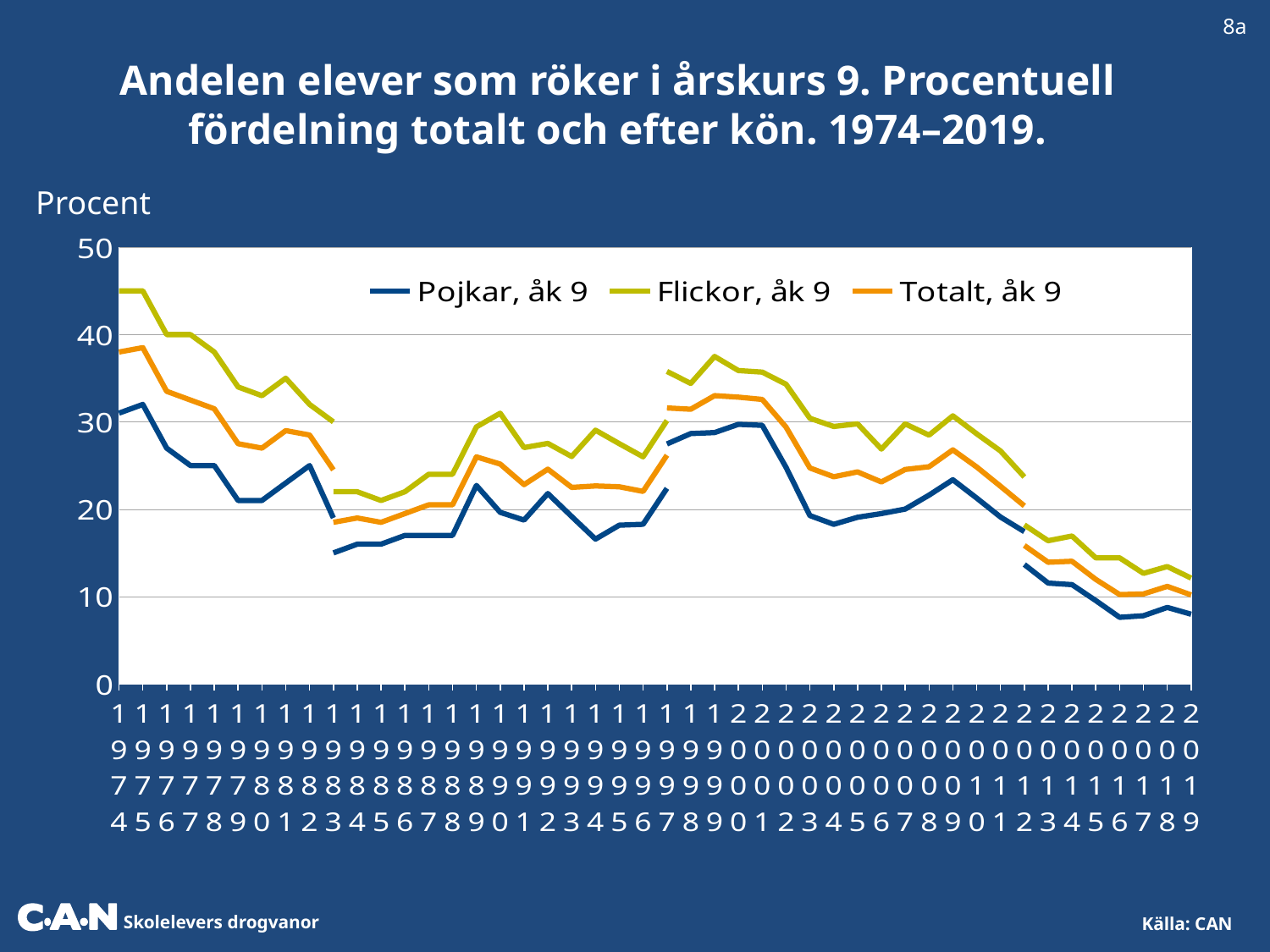
What kind of chart is shown on the slide? line chart Is the value for Pojkar, åk 9 in 1994 greater or less than 20? less Is the value for Pojkar, åk 9 in 2019 greater or less than 10? less Overall, do the values for Flickor, åk 9 rise or fall from 1974 to 2019? fall What are the three series named in the legend? Pojkar, åk 9; Flickor, åk 9; Totalt, åk 9 What is the label shown above the vertical axis? Procent Which series has the highest value in 1974? Flickor, åk 9 Is the value for Flickor, åk 9 in 1974 greater or less than 40? greater How many series does the legend list? 3 How many years are shown along the x axis? 46 In 1974, which series has the higher value: Pojkar, åk 9 or Flickor, åk 9? Flickor, åk 9